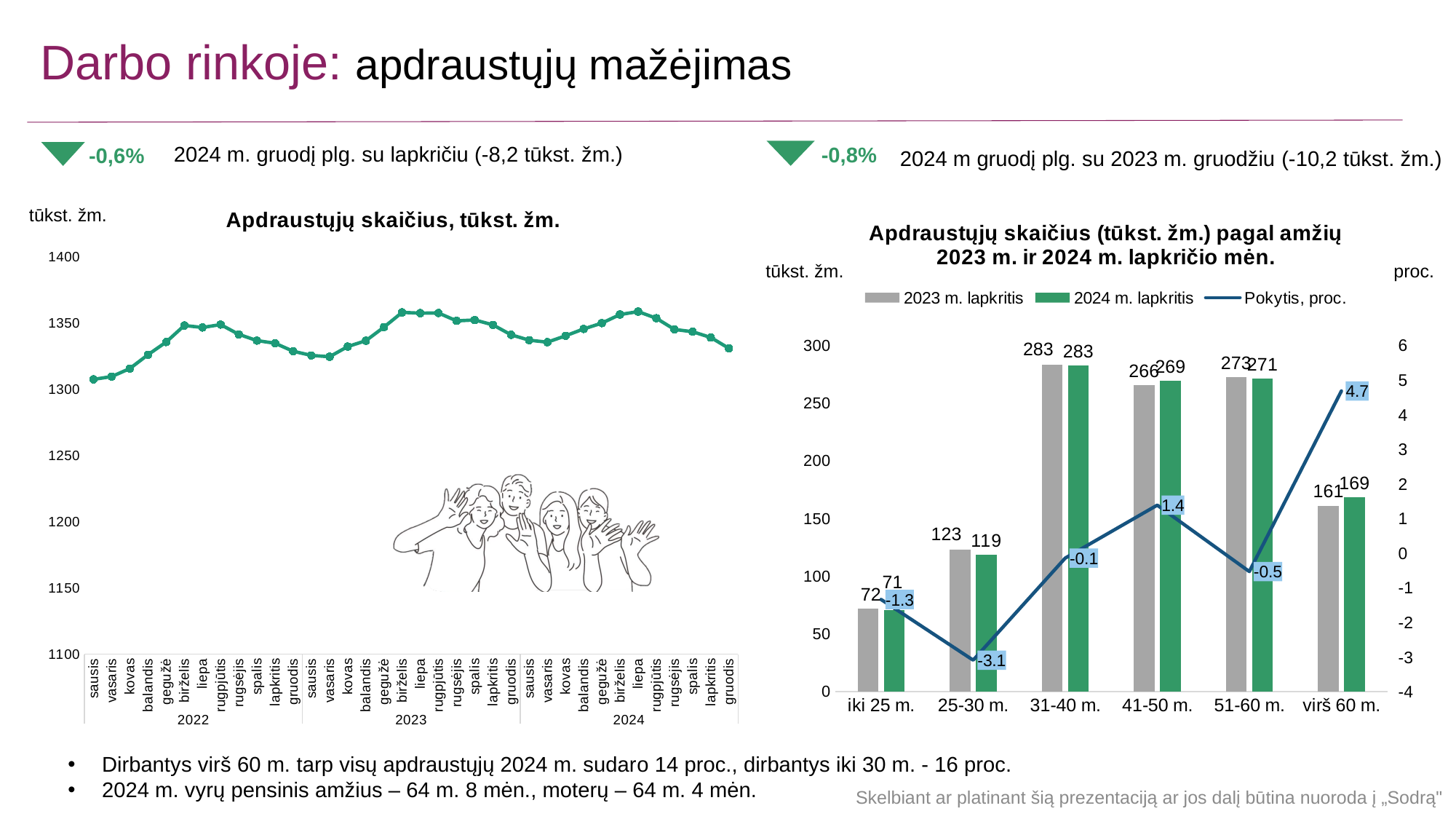
In the chart 'Apdraustųjų skaičius (tūkst. žm.) pagal amžių 2023 m. ir 2024 m. lapkričio mėn.', what is the 'Pokytis, proc.' value for 'virš 60 m.'? 4.7 In the chart 'Apdraustųjų skaičius (tūkst. žm.) pagal amžių 2023 m. ir 2024 m. lapkričio mėn.', which is larger for '25-30 m.': the '2023 m. lapkritis' value or the '2024 m. lapkritis' value? 2023 m. lapkritis In the chart 'Apdraustųjų skaičius (tūkst. žm.) pagal amžių 2023 m. ir 2024 m. lapkričio mėn.', what is the difference between the '2023 m. lapkritis' and '2024 m. lapkritis' values for 'virš 60 m.'? 8 In the chart 'Apdraustųjų skaičius, tūkst. žm.', do the values rise or fall from liepa 2024 to gruodis 2024? fall What kind of chart is 'Apdraustųjų skaičius, tūkst. žm.' on the left of the slide? line chart How many age groups are shown on the x axis of the chart 'Apdraustųjų skaičius (tūkst. žm.) pagal amžių 2023 m. ir 2024 m. lapkričio mėn.'? 6 In the chart 'Apdraustųjų skaičius (tūkst. žm.) pagal amžių 2023 m. ir 2024 m. lapkričio mėn.', what is the value for '41-50 m.' in the '2024 m. lapkritis' series? 269 In the chart 'Apdraustųjų skaičius (tūkst. žm.) pagal amžių 2023 m. ir 2024 m. lapkričio mėn.', which age group has the lowest 'Pokytis, proc.' value? 25-30 m. In the chart 'Apdraustųjų skaičius (tūkst. žm.) pagal amžių 2023 m. ir 2024 m. lapkričio mėn.', which age group has the lowest value in the '2023 m. lapkritis' series? iki 25 m. How many series does the legend of the chart 'Apdraustųjų skaičius (tūkst. žm.) pagal amžių 2023 m. ir 2024 m. lapkričio mėn.' list? 3 In the chart 'Apdraustųjų skaičius, tūkst. žm.', is the value for liepa 2023 greater or less than 1350? greater In the chart 'Apdraustųjų skaičius, tūkst. žm.', is the value for sausis 2022 greater or less than 1350? less